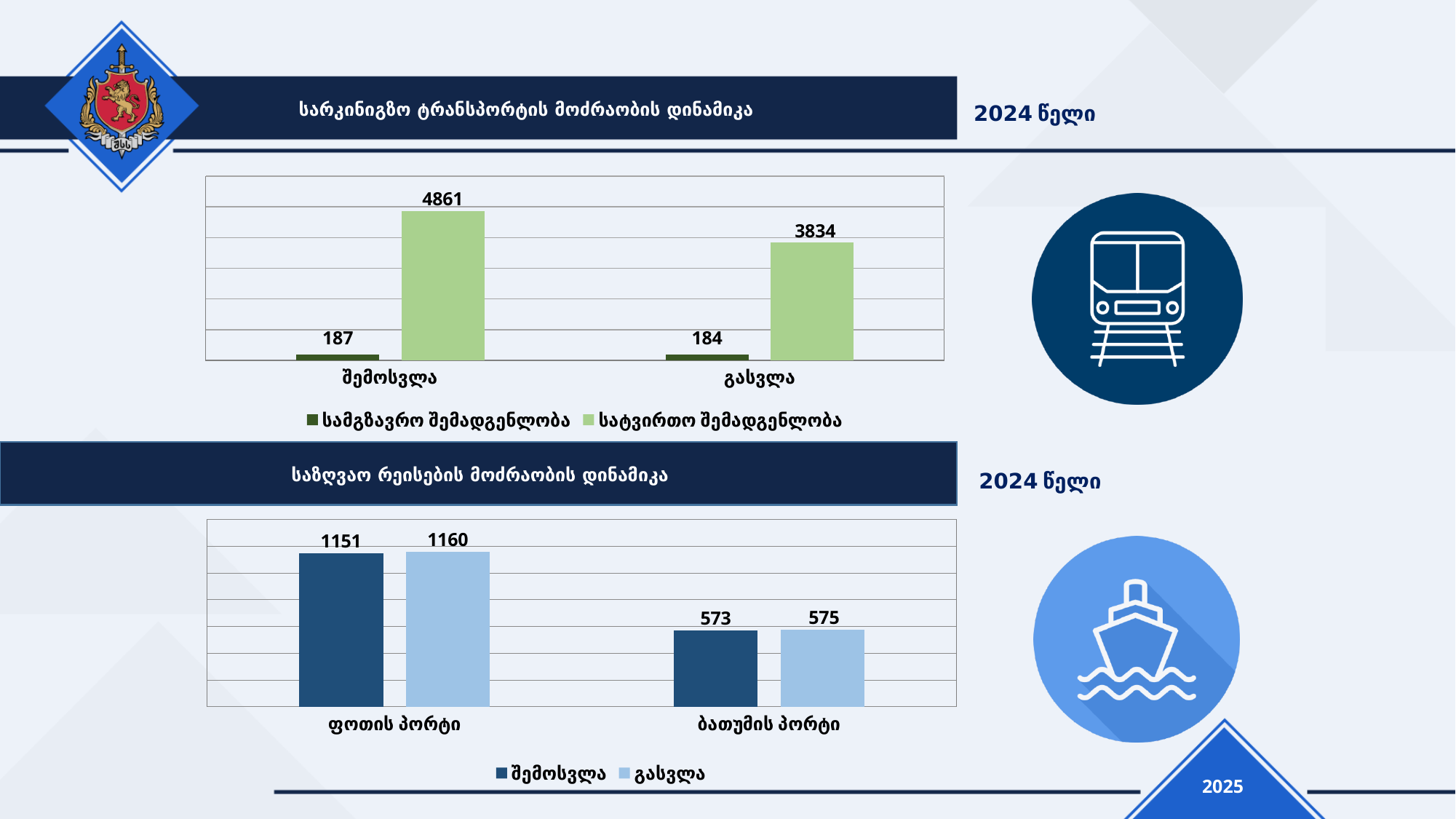
What colour are the გასვლა bars in the bottom chart? Light blue In the bottom chart, what is the გასვლა value for ბათუმის პორტი? 575 How many series does the legend of the top chart list? 2 How many categories are shown on the x axis of the bottom chart? 2 In the top chart, what is the difference between the სატვირთო შემადგენლობა values for შემოსვლა and გასვლა? 1027 In the top chart, which series has the higher value for შემოსვლა, სამგზავრო შემადგენლობა or სატვირთო შემადგენლობა? სატვირთო შემადგენლობა In the top chart (სარკინიგზო ტრანსპორტის მოძრაობის დინამიკა), what is the value of სატვირთო შემადგენლობა for შემოსვლა? 4861 What type of chart is the top chart on the slide? Bar chart In the bottom chart, which port has the higher შემოსვლა value? ფოთის პორტი In the bottom chart, what is the difference between the გასვლა values for ფოთის პორტი and ბათუმის პორტი? 585 In the top chart, what is the value of სამგზავრო შემადგენლობა for გასვლა? 184 In the bottom chart (საზღვაო რეისების მოძრაობის დინამიკა), what is the შემოსვლა value for ფოთის პორტი? 1151